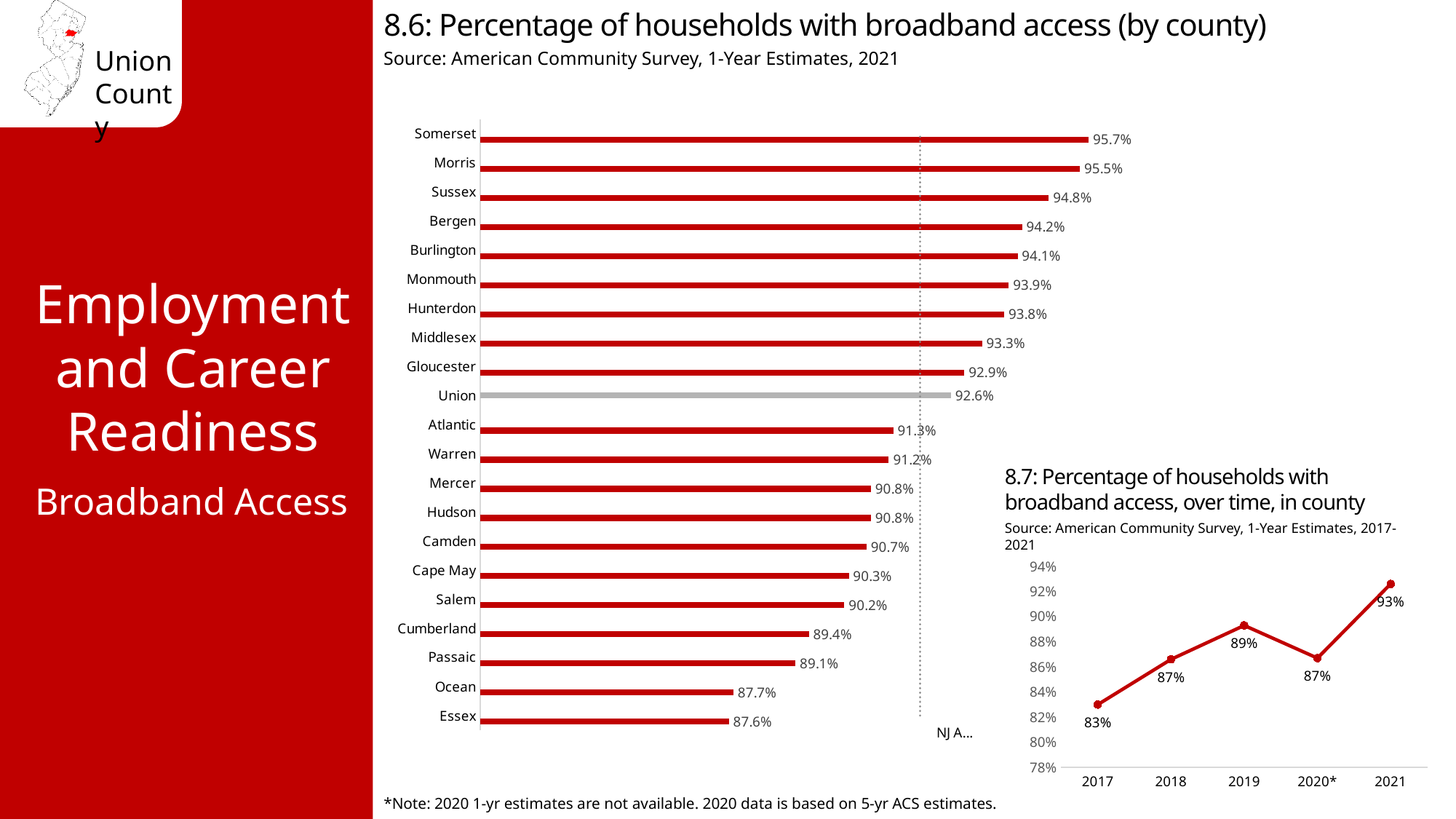
In chart 8.7, how many years are plotted? 5 In chart 8.6, which county has the lowest percentage of households with broadband access? Essex In chart 8.6, which county has a higher value, Bergen or Middlesex? Bergen In chart 8.7, what was the percentage of households with broadband access in 2017? 83% In chart 8.7, what is the difference between the 2021 value and the 2017 value? 10 percentage points In chart 8.6, what is the difference between Somerset's value and Essex's value? 8.1 percentage points What kind of chart is chart 8.6? Bar chart In chart 8.6, what is the value for Cumberland? 89.4% In chart 8.6, how many counties are shown? 21 In chart 8.6, what is the percentage of households with broadband access in Union County? 92.6% In chart 8.6, which county has the highest percentage of households with broadband access? Somerset In chart 8.7, which year has the highest percentage of households with broadband access? 2021